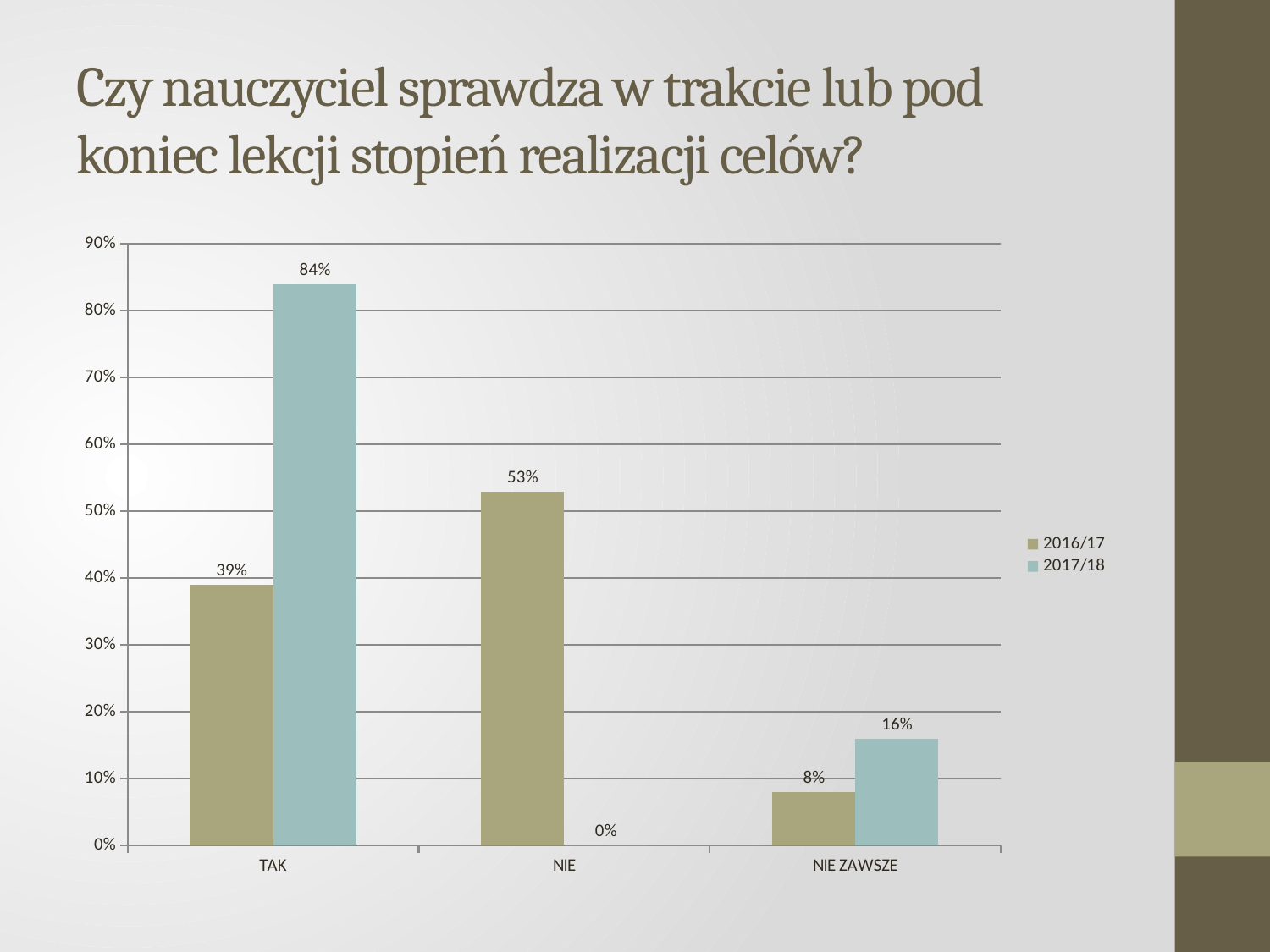
What kind of chart is shown on the slide? Bar chart What is the value for NIE ZAWSZE in the 2017/18 series? 16% What is the value for NIE in the 2017/18 series? 0% Which is larger for NIE ZAWSZE: the 2016/17 value or the 2017/18 value? 2017/18 What is the value for TAK in the 2017/18 series? 84% What is the difference between the 2017/18 and 2016/17 values for TAK? 45% Which category has the lowest value in the 2017/18 series? NIE What is the value for NIE in the 2016/17 series? 53% Which category has the highest value in the 2016/17 series? NIE How many series does the legend list? 2 How many categories are shown on the x axis? 3 Which series is shown in the lighter blue-grey colour? 2017/18